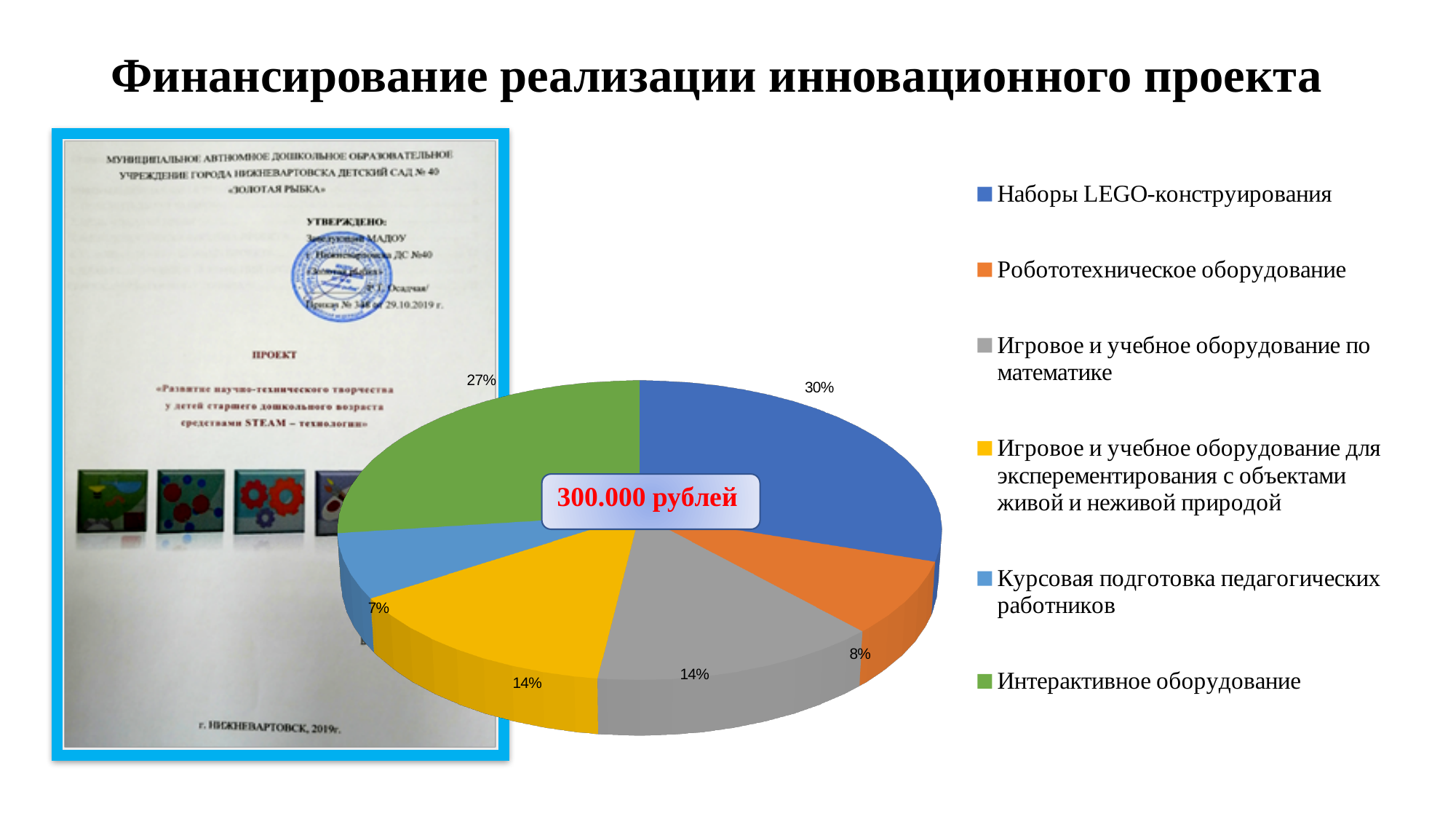
Which category has the largest share of the pie? Наборы LEGO-конструирования What share of the funding goes to Интерактивное оборудование? 27% How many categories does the pie chart have? 6 What share of the funding goes to Курсовая подготовка педагогических работников? 7% What kind of chart is shown on the slide? pie chart What share of the funding goes to Наборы LEGO-конструирования? 30% What total amount of funding is shown in the centre of the pie chart? 300.000 рублей What share of the funding goes to Игровое и учебное оборудование по математике? 14% Which category has the smallest share of the pie? Курсовая подготовка педагогических работников Which is larger: the share for Наборы LEGO-конструирования or for Интерактивное оборудование? Наборы LEGO-конструирования What is the difference in percentage points between the share for Наборы LEGO-конструирования and the share for Интерактивное оборудование? 3 percentage points What share of the funding goes to Робототехническое оборудование? 8%